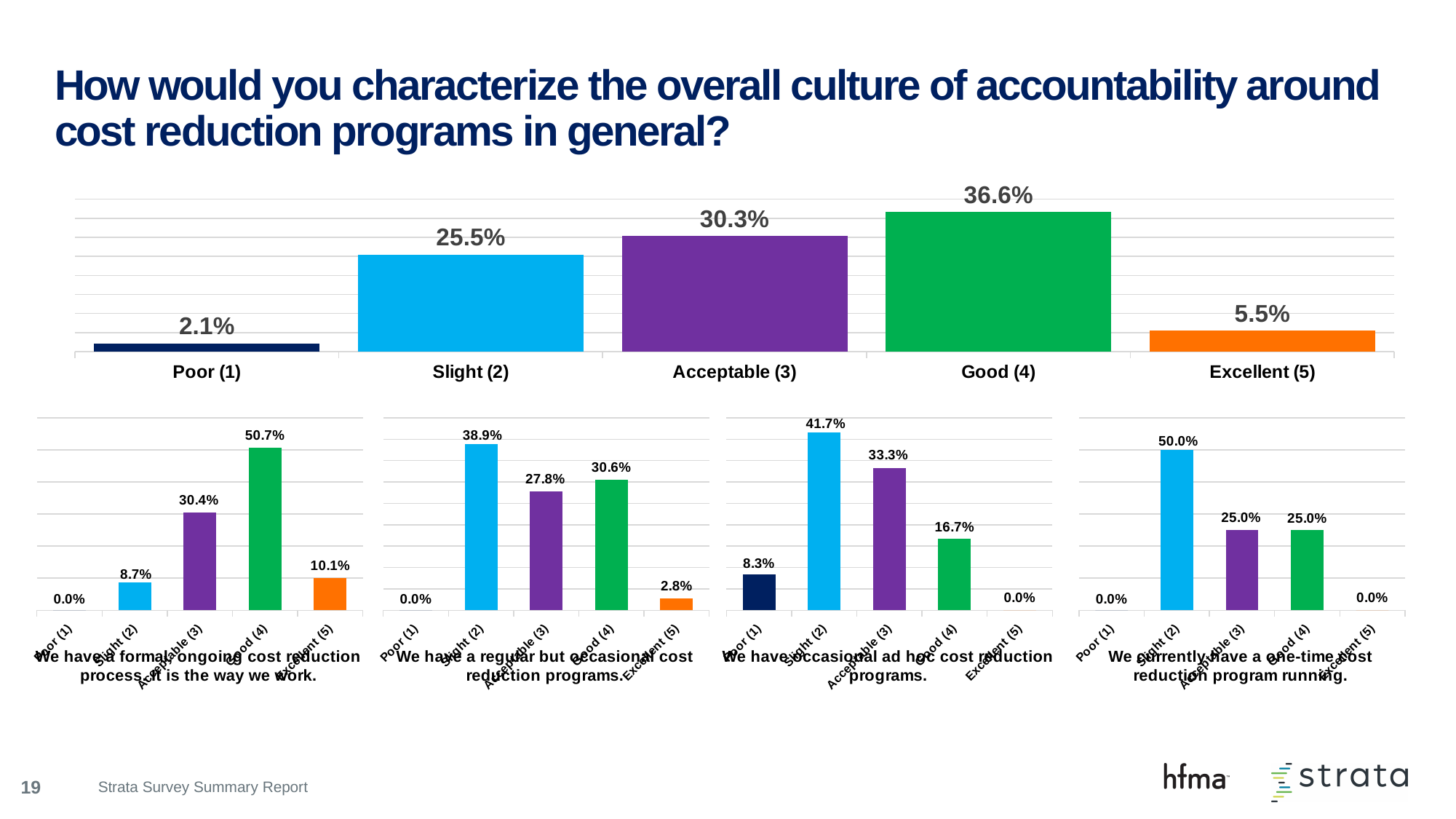
In the top chart, what is the value for Poor (1)? 2.1% In the chart titled 'We have occasional ad hoc cost reduction programs.', what is the value for Poor (1)? 8.3% In the top chart, how many categories are shown? 5 In the top chart, what is the difference between Acceptable (3) and Slight (2)? 4.8% In the bottom-right chart titled 'We currently have a one-time cost reduction program running.', which is larger: Slight (2) or Acceptable (3)? Slight (2) In the chart titled 'We have a regular but occasional cost reduction programs.', which category has the highest value? Slight (2) In the top chart, which category has the lowest value? Poor (1) What kind of chart is the top chart? Bar chart In the chart titled 'We have occasional ad hoc cost reduction programs.', what is the difference between Slight (2) and Acceptable (3)? 8.4% In the top chart, which category has the highest value? Good (4) In the bottom-left chart titled 'We have a formal, ongoing cost reduction process. It is the way we work.', what is the value for Good (4)? 50.7% In the top chart, what is the value for Good (4)? 36.6%